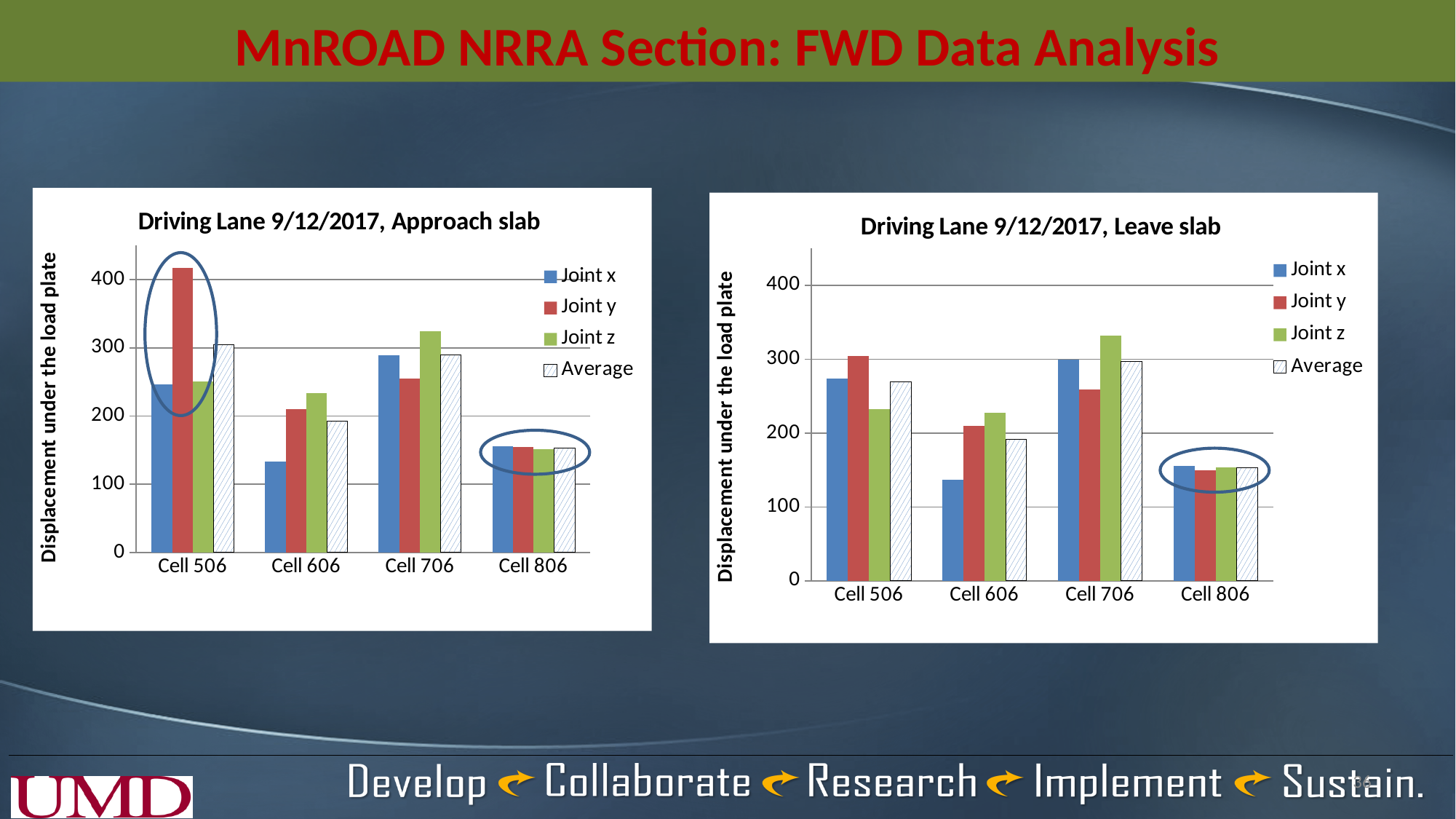
In the 'Driving Lane 9/12/2017, Approach slab' chart, which cell has the highest Joint y value? Cell 506 In the 'Driving Lane 9/12/2017, Leave slab' chart, is the Joint z value for Cell 706 greater or less than 300? greater In the 'Driving Lane 9/12/2017, Leave slab' chart, for Cell 506, which is larger: Joint x or Joint y? Joint y In the 'Driving Lane 9/12/2017, Leave slab' chart, is the Joint x value for Cell 606 greater or less than 200? less In the 'Driving Lane 9/12/2017, Approach slab' chart, is the Joint y value for Cell 506 greater or less than 400? greater In the 'Driving Lane 9/12/2017, Approach slab' chart, how many cells are shown on the x axis? 4 What kind of chart is the 'Driving Lane 9/12/2017, Approach slab' chart? Bar chart In the 'Driving Lane 9/12/2017, Leave slab' chart, how many series does the legend list? 4 What is the title of the chart on the left side of the slide? Driving Lane 9/12/2017, Approach slab In the 'Driving Lane 9/12/2017, Approach slab' chart, which cell has the lowest Joint x value? Cell 606 In the 'Driving Lane 9/12/2017, Leave slab' chart, which cell has the highest Joint z value? Cell 706 What is the y-axis label of the 'Driving Lane 9/12/2017, Leave slab' chart? Displacement under the load plate